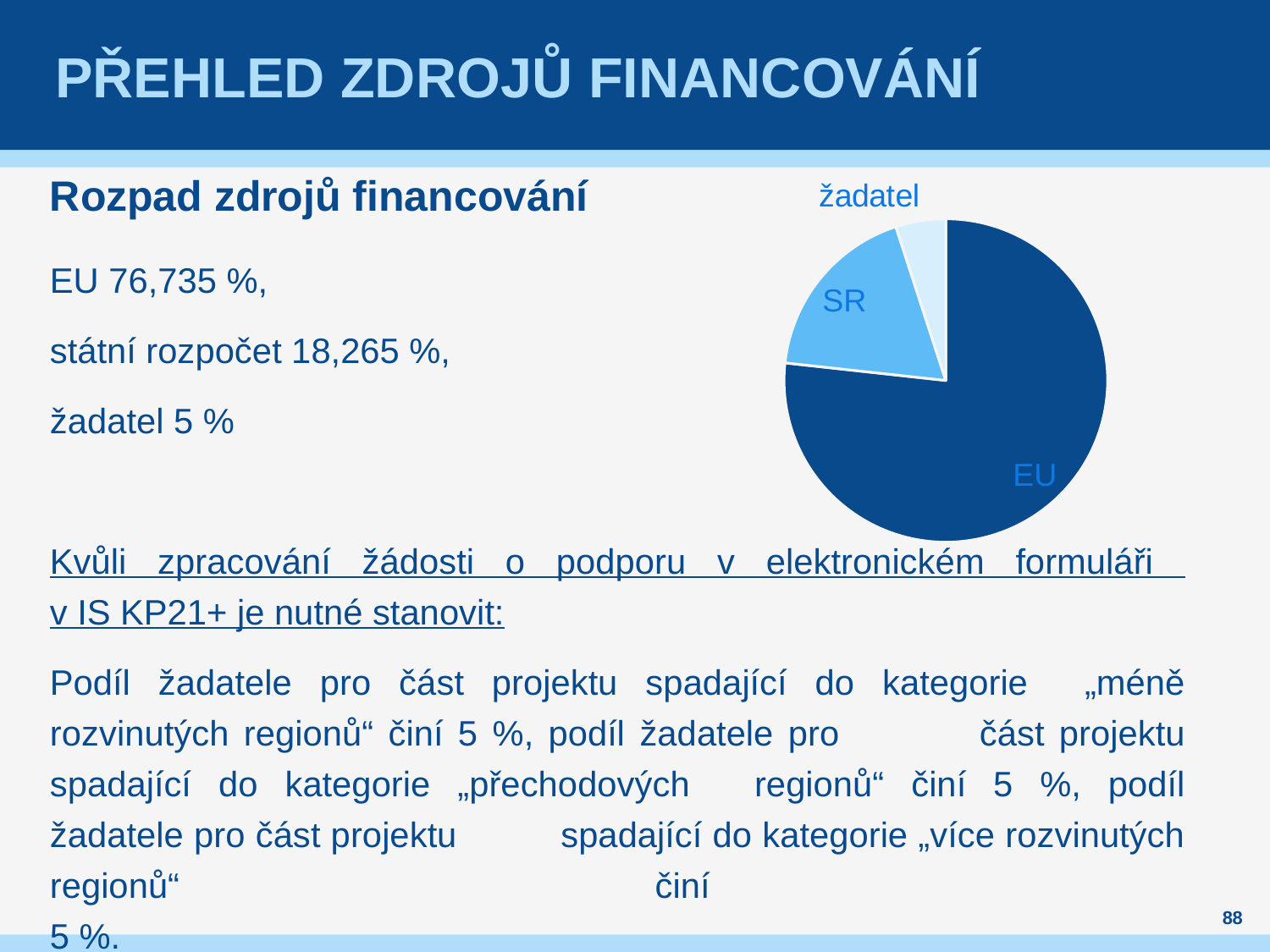
Which is larger in the pie chart, the SR slice or the žadatel slice? SR Which slice of the pie chart is the largest? EU How many slices does the pie chart have? 3 Which slice of the pie chart is the smallest? žadatel What kind of chart is shown on the slide? pie chart What share of the pie does the EU slice represent, according to the slide? 76,735 % What share of the pie does the SR (státní rozpočet) slice represent, according to the slide? 18,265 % What are the labels of the three slices in the pie chart? EU, SR, žadatel What share of the pie does the žadatel slice represent, according to the slide? 5 % What is the difference between the EU share and the státní rozpočet share shown on the slide? 58,47 % What colour is the EU slice in the pie chart? dark blue Is the EU slice of the pie chart greater or less than 50 %? greater